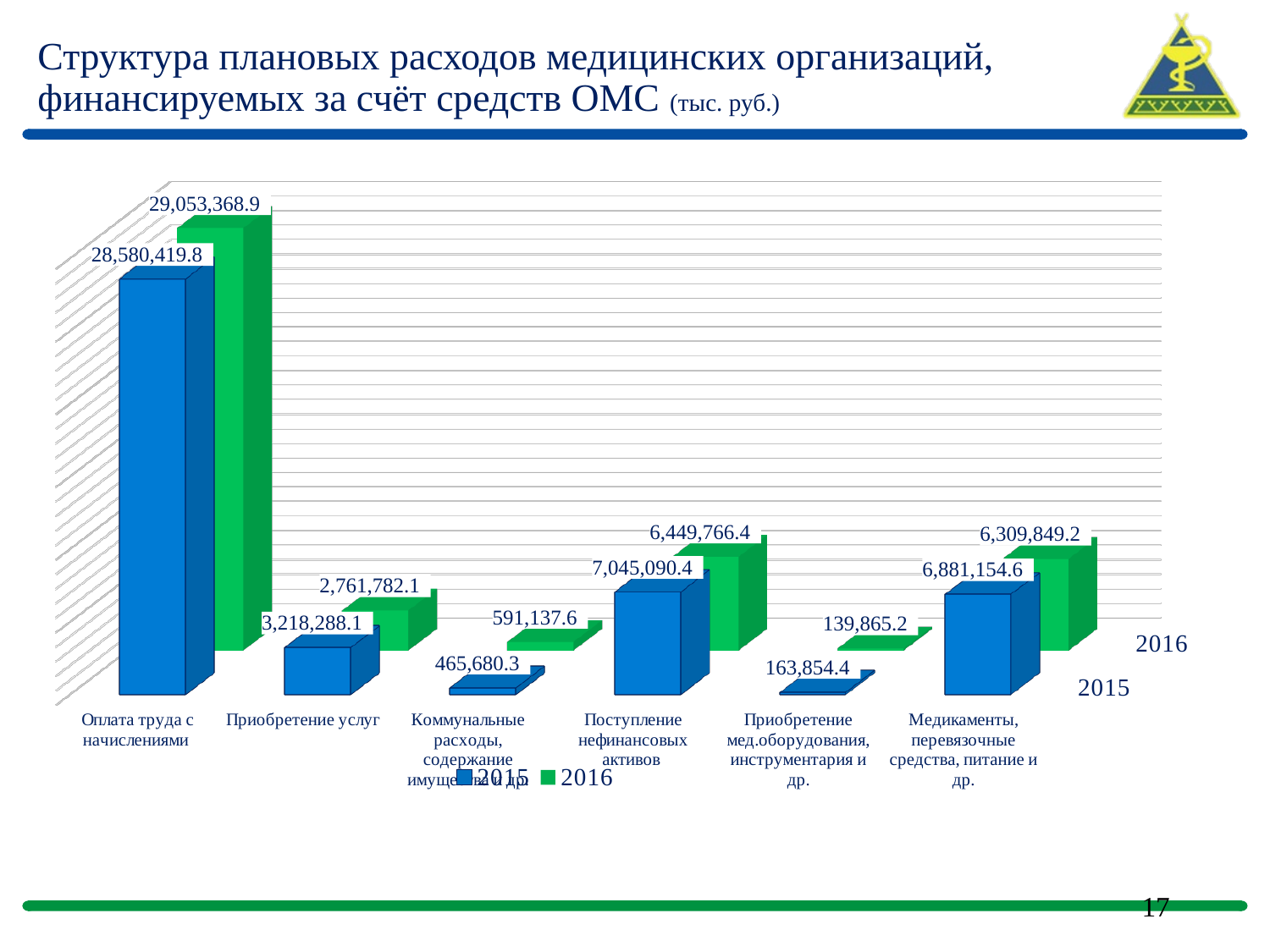
What is the difference between the 2015 and 2016 values for Поступление нефинансовых активов? 595,324.0 For Приобретение мед.оборудования, инструментария и др., which year has the larger value, 2015 or 2016? 2015 How many categories are shown on the x axis? 6 What is the difference between the 2016 and 2015 values for Оплата труда с начислениями? 472,949.1 Which category has the lowest 2015 value? Приобретение мед.оборудования, инструментария и др. What is the 2015 value for Медикаменты, перевязочные средства, питание и др.? 6,881,154.6 How many series does the legend list? 2 What is the 2016 value for Приобретение услуг? 2,761,782.1 What is the 2015 value for Оплата труда с начислениями? 28,580,419.8 What kind of chart is shown on the slide? Bar chart Which category has the highest 2016 value? Оплата труда с начислениями What is the 2016 value for Коммунальные расходы, содержание имущества и др.? 591,137.6